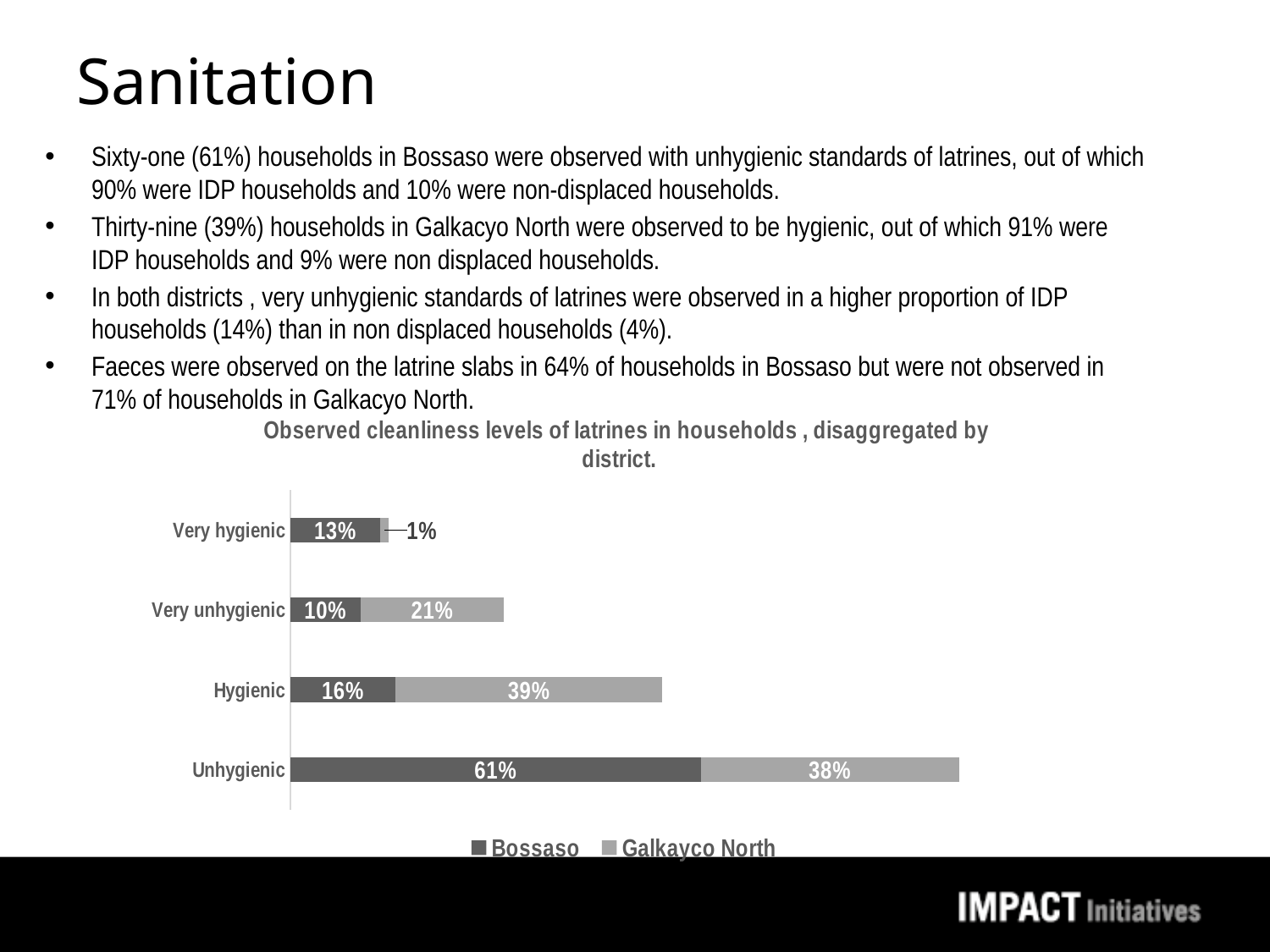
Which category has the lowest Galkayco North value? Very hygienic How many series does the legend list? 2 What is the Galkayco North value for Very hygienic? 1% For Hygienic, which is larger: the Bossaso value or the Galkayco North value? Galkayco North What is the difference between the Bossaso and Galkayco North values for Unhygienic? 23% How many categories are shown on the chart? 4 What is the Bossaso value for Unhygienic? 61% What is the Galkayco North value for Hygienic? 39% What kind of chart is shown? Stacked bar chart Which category has the highest Bossaso value? Unhygienic What is the Bossaso value for Very unhygienic? 10% What is the total of the stacked bar for Very unhygienic? 31%